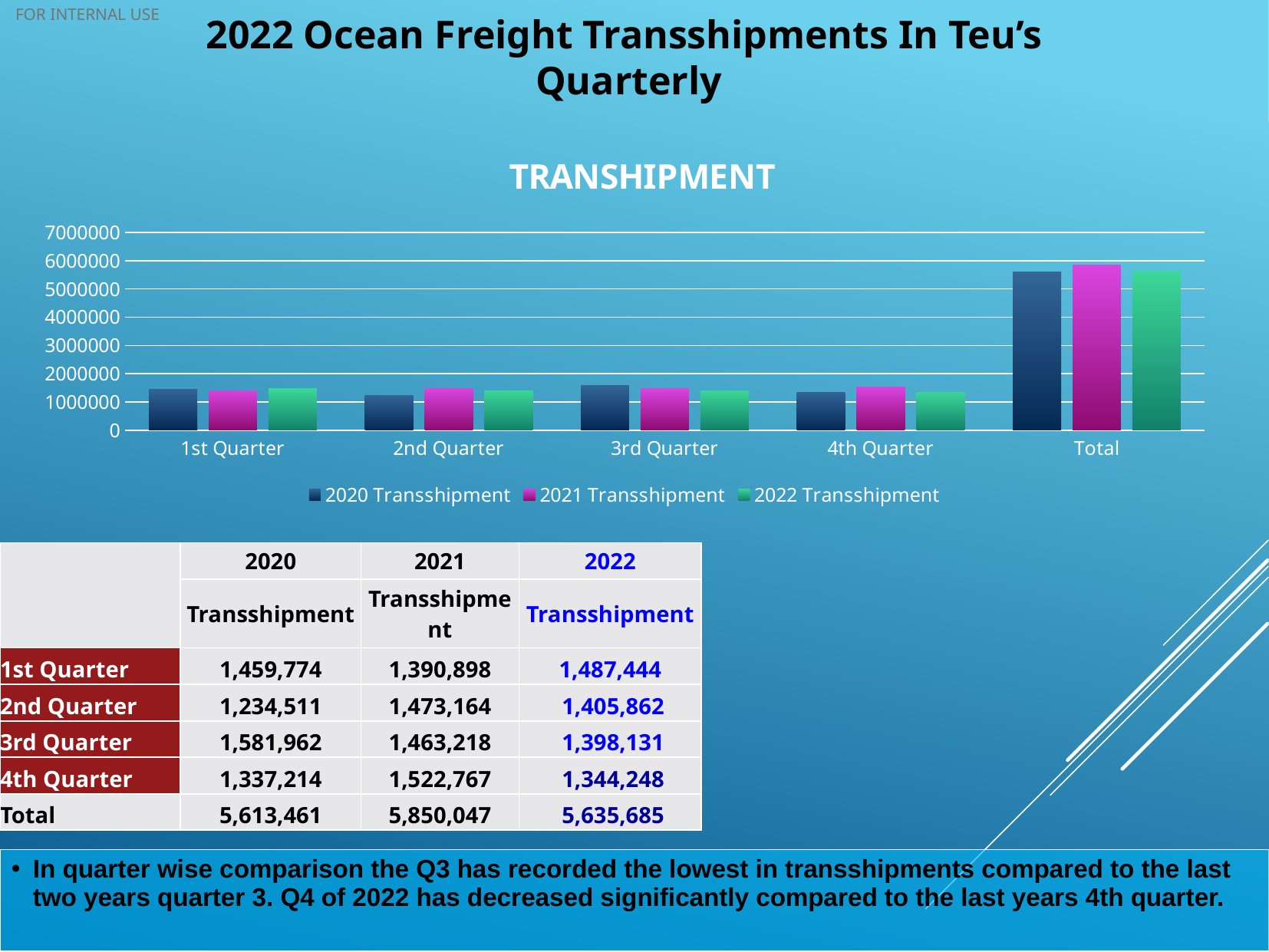
Which is larger for the Total category: 2020 Transshipment or 2021 Transshipment? 2021 Transshipment Which category has the highest values across all series? Total What is the 2020 Transshipment value for the 3rd Quarter? 1,581,962 What is the 2022 Transshipment value for the 1st Quarter? 1,487,444 What is the 2021 Transshipment value for the Total category? 5,850,047 Which quarter has the lowest 2020 Transshipment value? 2nd Quarter What is the title of the chart? TRANSHIPMENT What is the difference between the 2021 Transshipment total and the 2020 Transshipment total? 236,586 How many categories are shown on the x axis of the chart? 5 How many series does the chart legend list? 3 Is the 2020 Transshipment value for the 1st Quarter greater or less than 2000000? less What kind of chart is shown on the slide? bar chart